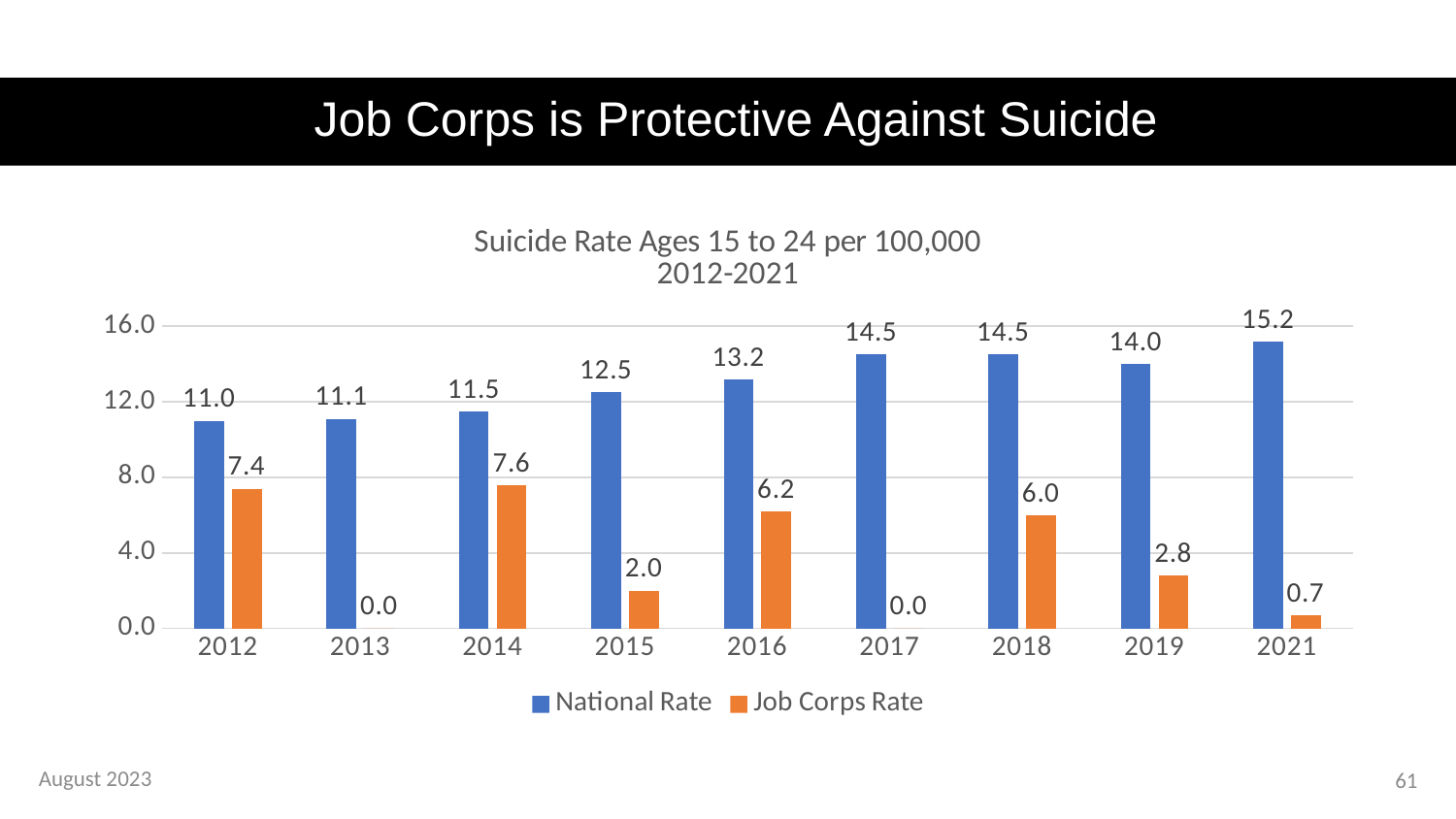
What kind of chart is shown on the slide? Bar chart How many years are shown on the x axis? 9 Does the National Rate generally rise or fall from 2012 to 2021? Rise What is the difference between the National Rate and the Job Corps Rate in 2021? 14.5 What is the National Rate for 2016? 13.2 What is the difference between the National Rate in 2012 and in 2021? 4.2 How many series does the legend list? 2 Which is larger, the Job Corps Rate in 2015 or in 2019? 2019 What is the Job Corps Rate for 2014? 7.6 Which year has the highest Job Corps Rate? 2014 Is the National Rate for 2017 greater or less than 12.0? greater Which year has the highest National Rate? 2021